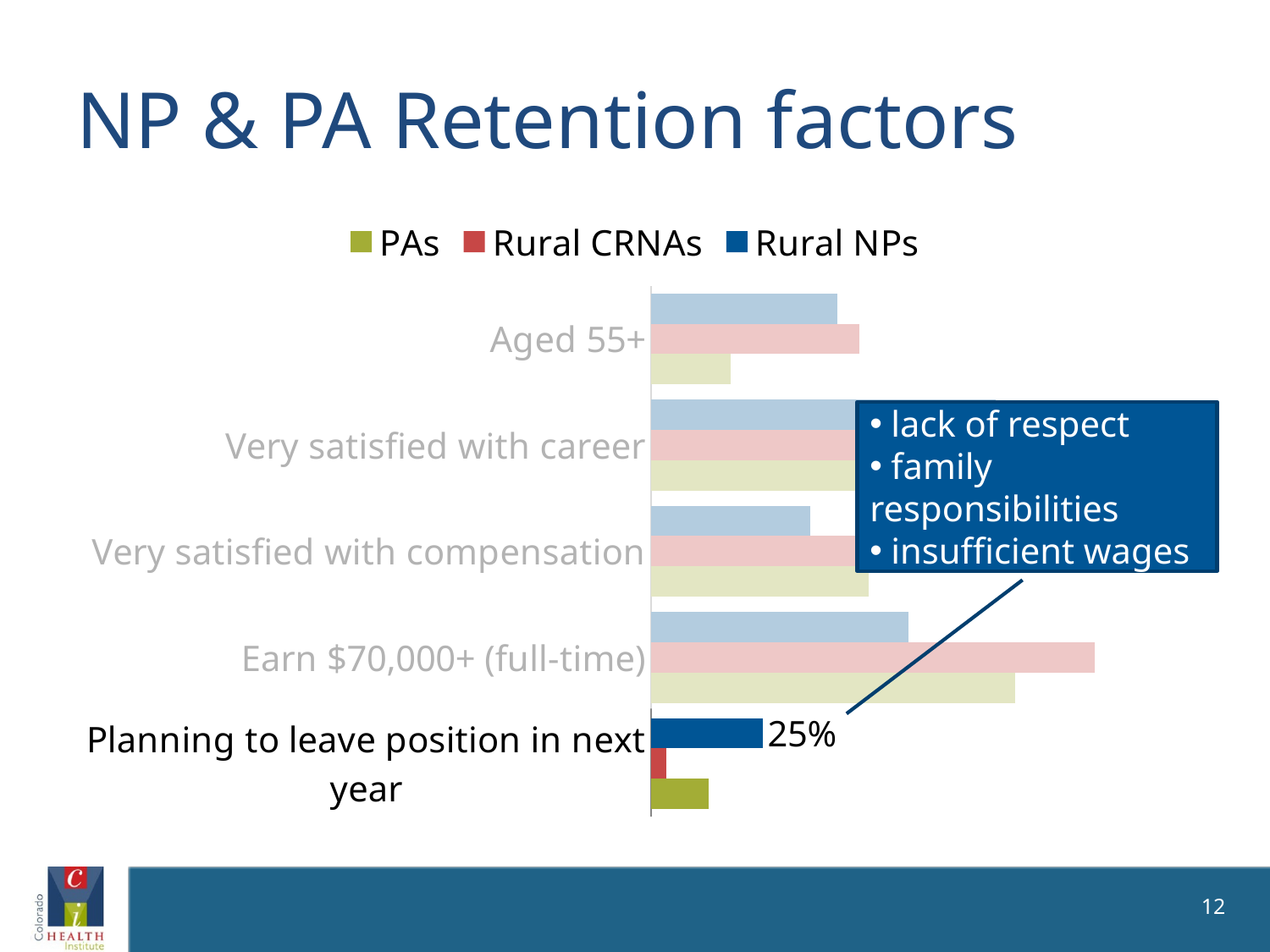
What percentage of Rural NPs are planning to leave their position in the next year? 25% For 'Very satisfied with compensation', which series has the lowest value? Rural NPs Which series is shown in blue in the legend? Rural NPs What is the title of the slide containing the chart? NP & PA Retention factors For 'Planning to leave position in next year', which is larger: Rural NPs or Rural CRNAs? Rural NPs For 'Earn $70,000+ (full-time)', which series has the highest value? Rural CRNAs How many series does the legend list? 3 What kind of chart is shown on the slide? bar chart For 'Aged 55+', which is larger: Rural CRNAs or Rural NPs? Rural CRNAs For 'Aged 55+', which series has the lowest value? PAs How many categories are plotted on the chart? 5 For 'Planning to leave position in next year', which series has the lowest value? Rural CRNAs